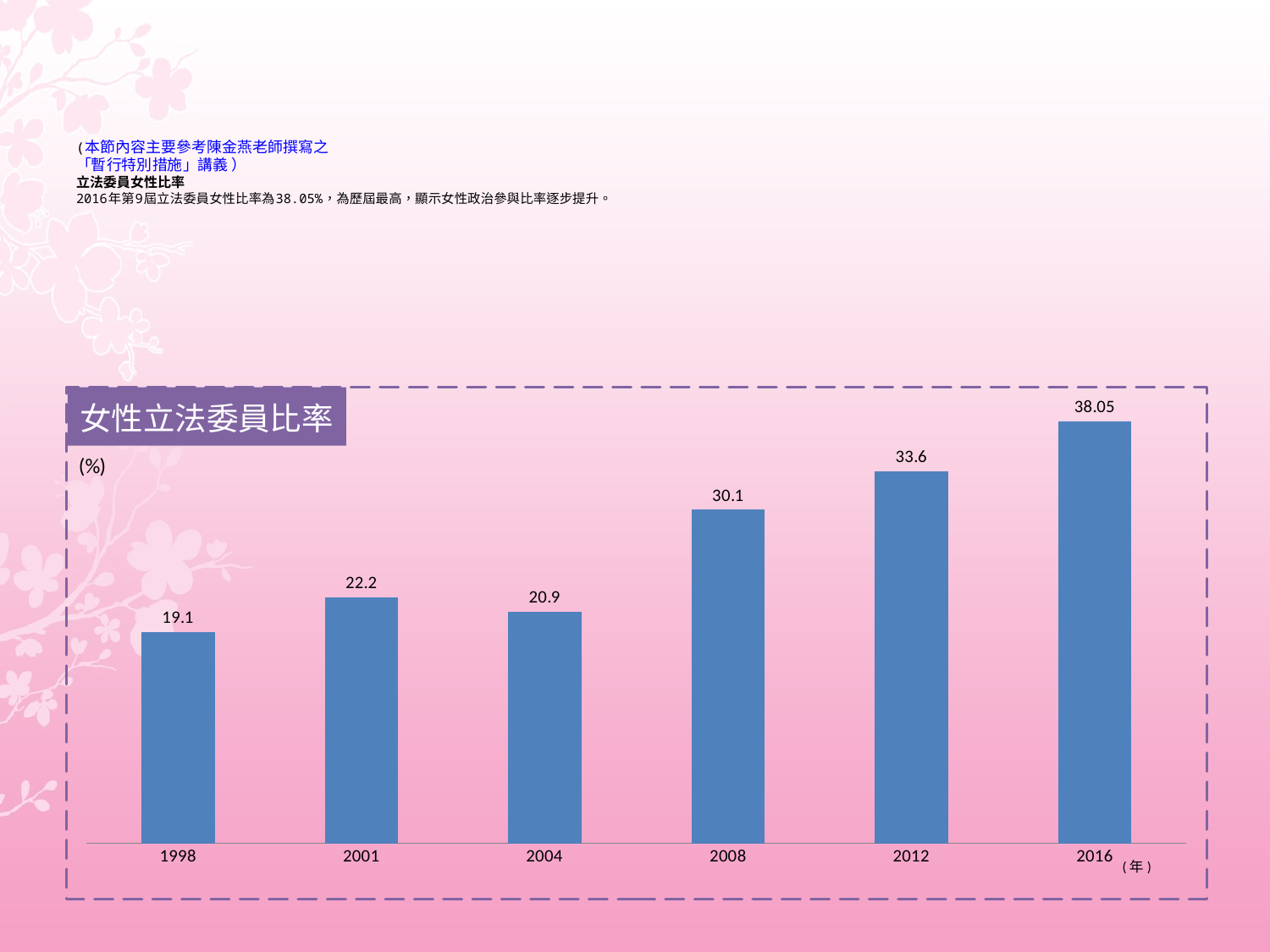
Do the values generally rise or fall from 1998 to 2016? rise What is the value for 2004? 20.9 Which is larger, the value for 2001 or the value for 2004? 2001 What is the value for 1998? 19.1 Which year has the lowest value? 1998 What kind of chart is this? bar chart How many years are shown on the x axis? 6 What is the title of the chart? 女性立法委員比率 What is the difference between the values for 2001 and 2004? 1.3 Which year has the highest value? 2016 What is the value for 2016? 38.05 What is the difference between the values for 2016 and 2012? 4.45